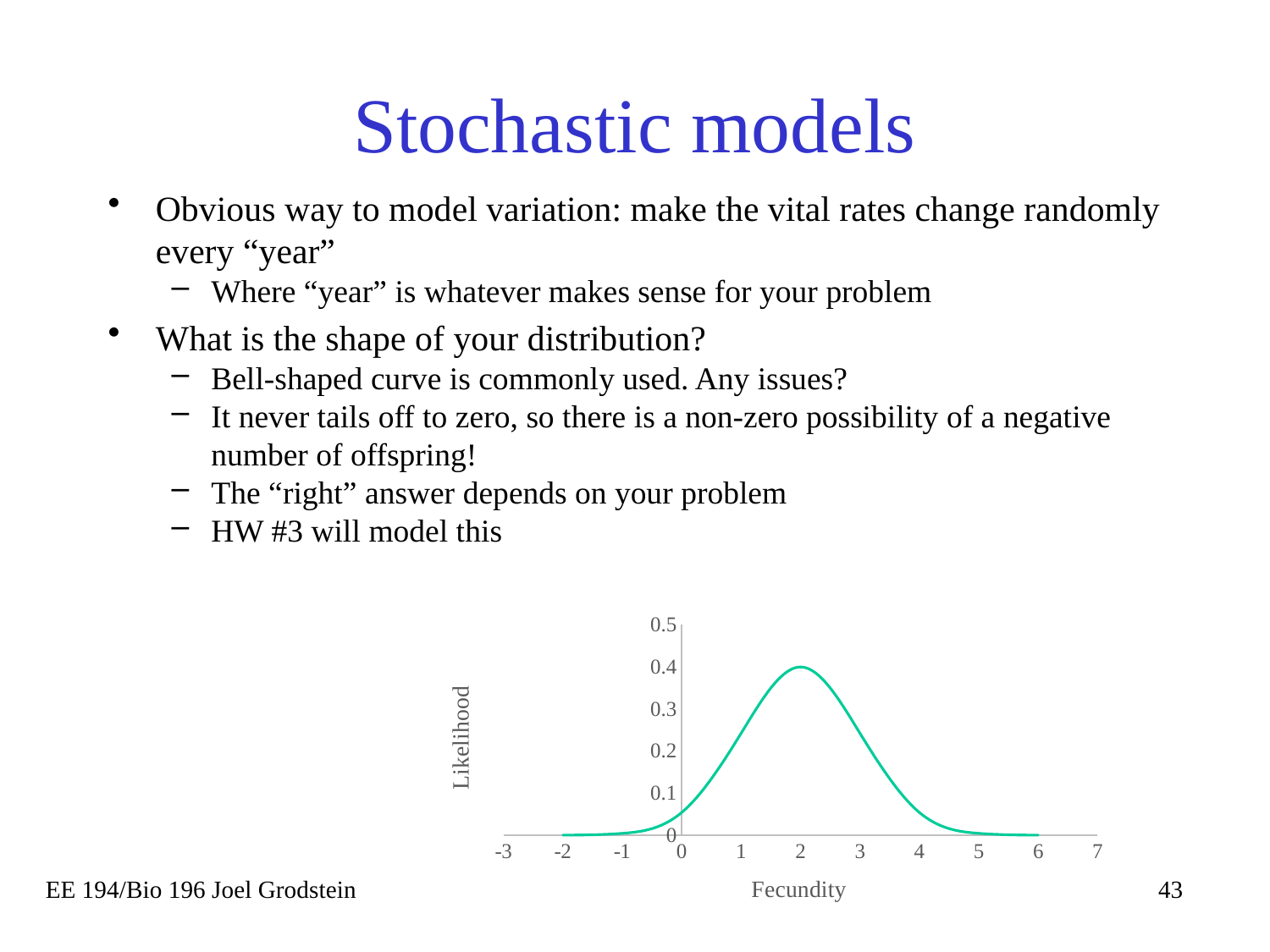
Is the likelihood at a fecundity of 0 greater or less than 0.1? less How many series are plotted on the chart? 1 Does the likelihood rise or fall as fecundity increases from -1 to 2? rise Is the likelihood at a fecundity of 2 greater or less than 0.3? greater Is the likelihood at a fecundity of 2 greater or less than 0.5? less What is the label of the x axis of the chart? Fecundity Does the likelihood rise or fall as fecundity increases from 2 to 5? fall At which fecundity value does the curve reach its highest likelihood? 2 Which has the higher likelihood: a fecundity of 1 or a fecundity of 4? 1 What is the label of the y axis of the chart? Likelihood What kind of chart is shown on the slide? line chart